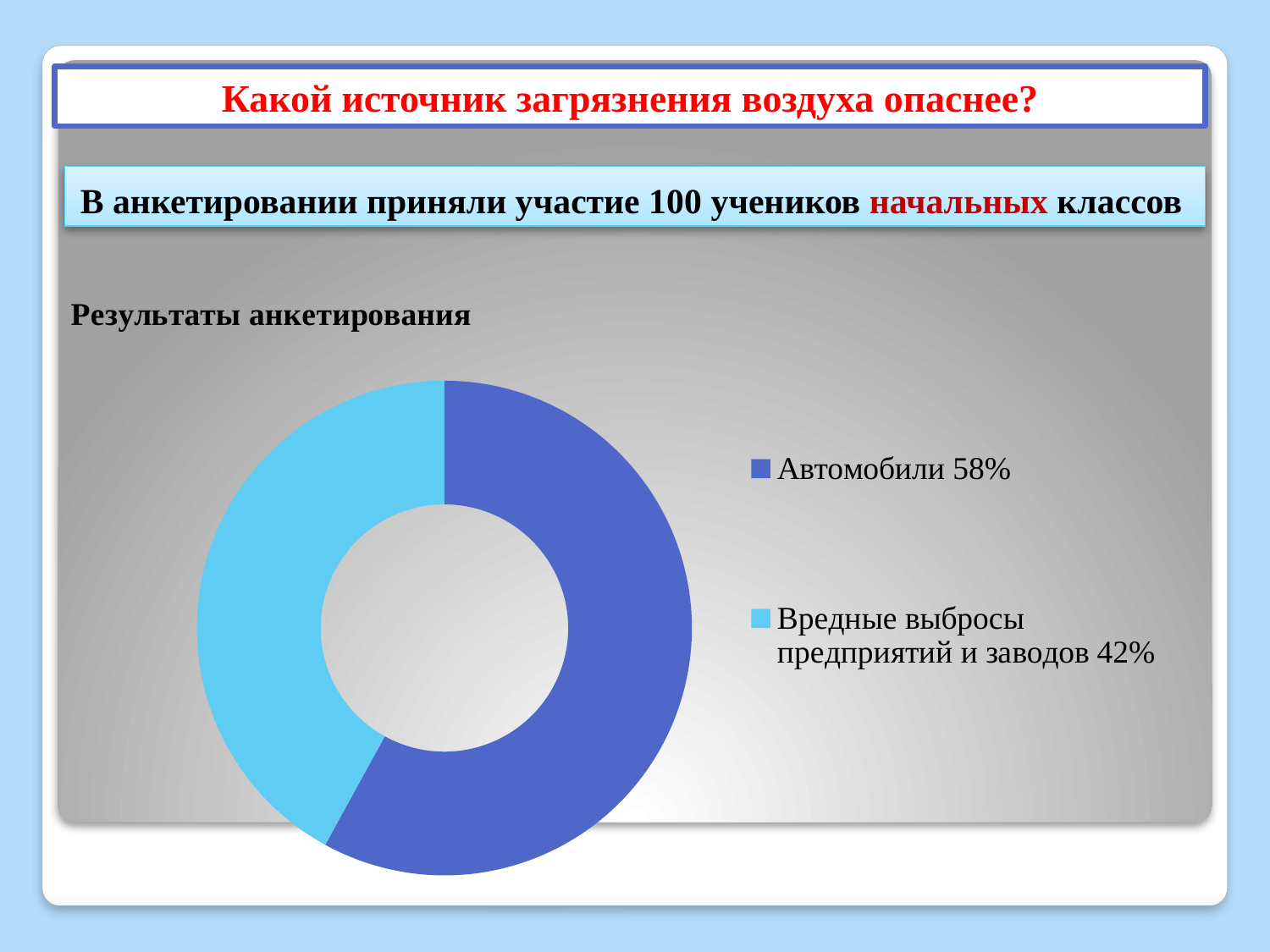
Which category has the smallest share in the chart? Вредные выбросы предприятий и заводов Is the share for "Автомобили" greater or less than 50%? greater What colour is the slice for "Вредные выбросы предприятий и заводов"? Light blue What kind of chart is shown on the slide? Doughnut (pie) chart What colour is the slice for "Автомобили"? Dark blue How many entries does the legend list? 2 What share of the chart does "Вредные выбросы предприятий и заводов" represent? 42% Which category has the largest share in the chart? Автомобили Which is larger: the share for "Автомобили" or for "Вредные выбросы предприятий и заводов"? Автомобили What is the difference in percentage points between "Автомобили" and "Вредные выбросы предприятий и заводов"? 16 How many categories does the chart show? 2 What share of the chart does "Автомобили" represent? 58%